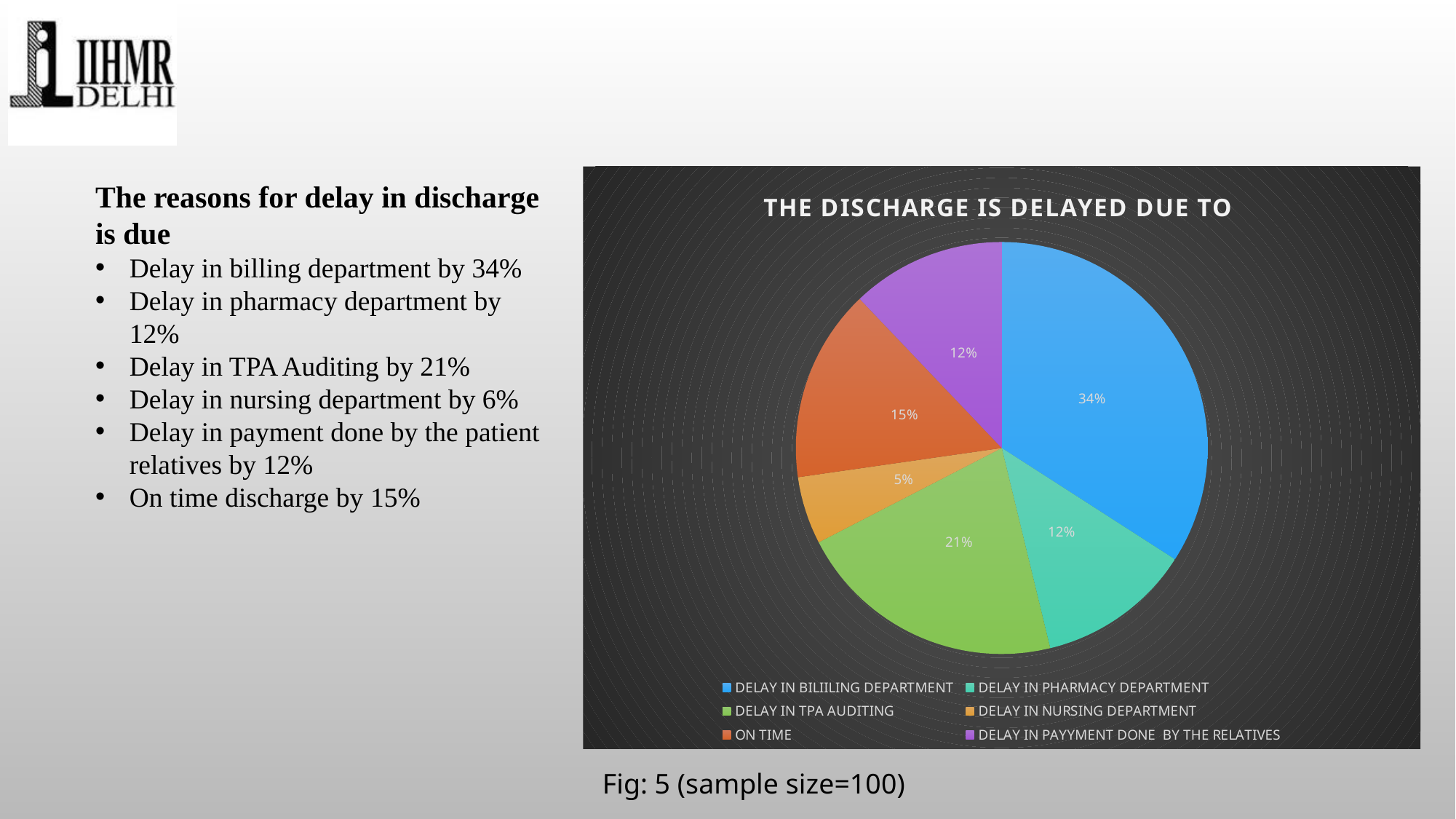
What type of chart is shown on the slide? pie chart What percentage of the pie is labelled for on time discharge? 15% Which category has the smallest slice of the pie? DELAY IN NURSING DEPARTMENT Which is larger: the share for delay in TPA auditing or the share for on time? DELAY IN TPA AUDITING Which category has the largest slice of the pie? DELAY IN BILIILING DEPARTMENT What is the difference between the billing department delay share and the TPA auditing delay share? 13% What percentage of the pie is attributed to delay in TPA auditing? 21% What percentage of the pie is attributed to delay in billing department? 34% What is the title of the chart? THE DISCHARGE IS DELAYED DUE TO What colour is the slice for delay in payment done by the relatives? purple What percentage does the chart show for delay in nursing department? 5% How many categories does the pie chart have? 6